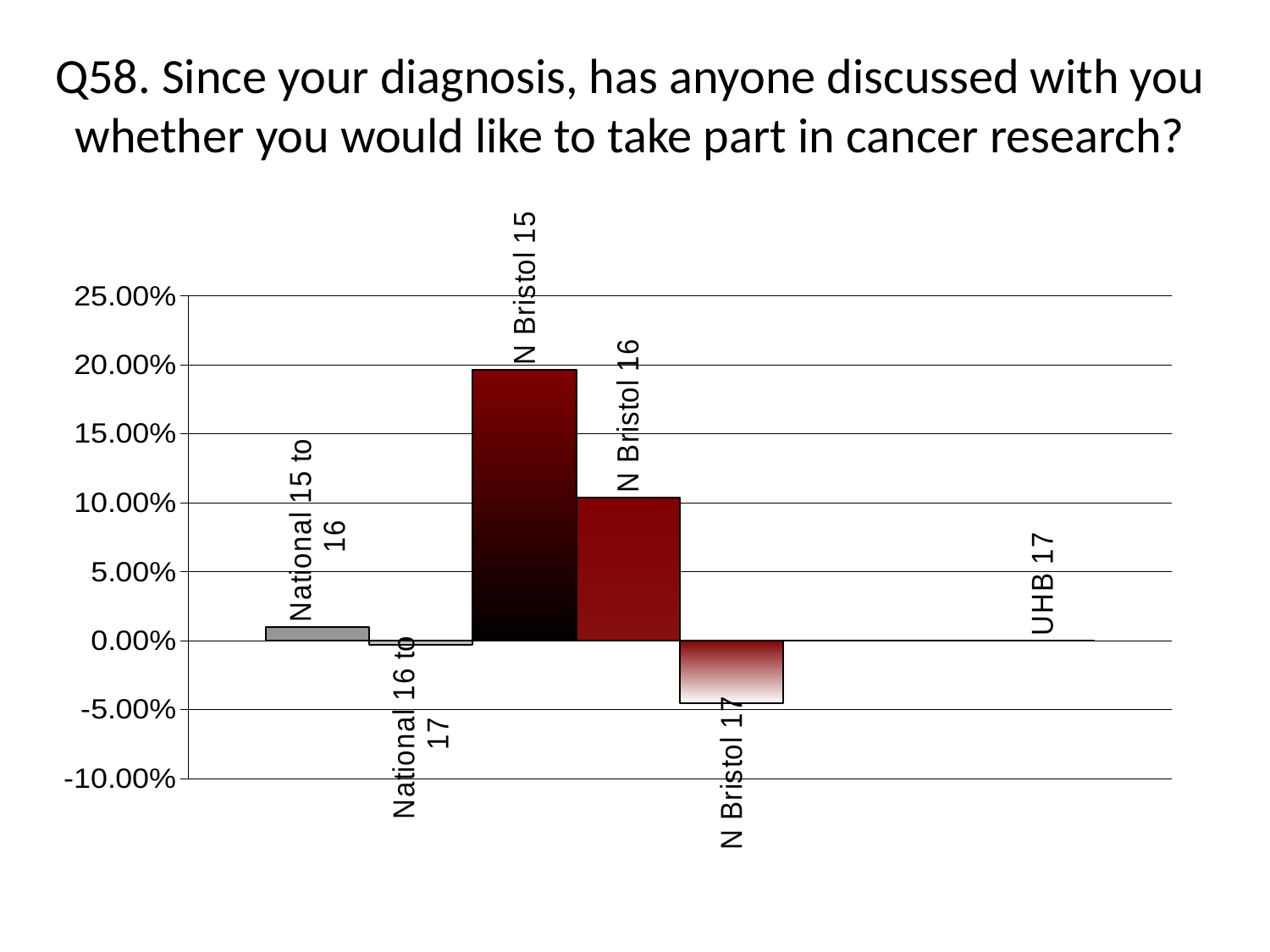
Which is larger, the value for N Bristol 15 or the value for N Bristol 16? N Bristol 15 What kind of chart is shown on the slide? bar chart Which category has the lowest value? N Bristol 17 How many categories are labelled on the chart? 6 Is the value for National 15 to 16 greater or less than 5.00%? less Is the value for N Bristol 16 greater or less than 5.00%? greater Which category has the highest value? N Bristol 15 Is the value for N Bristol 17 greater or less than 0.00%? less What is the title of the chart? Q58. Since your diagnosis, has anyone discussed with you whether you would like to take part in cancer research? Which is larger, the value for National 15 to 16 or the value for N Bristol 17? National 15 to 16 Do the values fall or rise from N Bristol 15 to N Bristol 17? fall